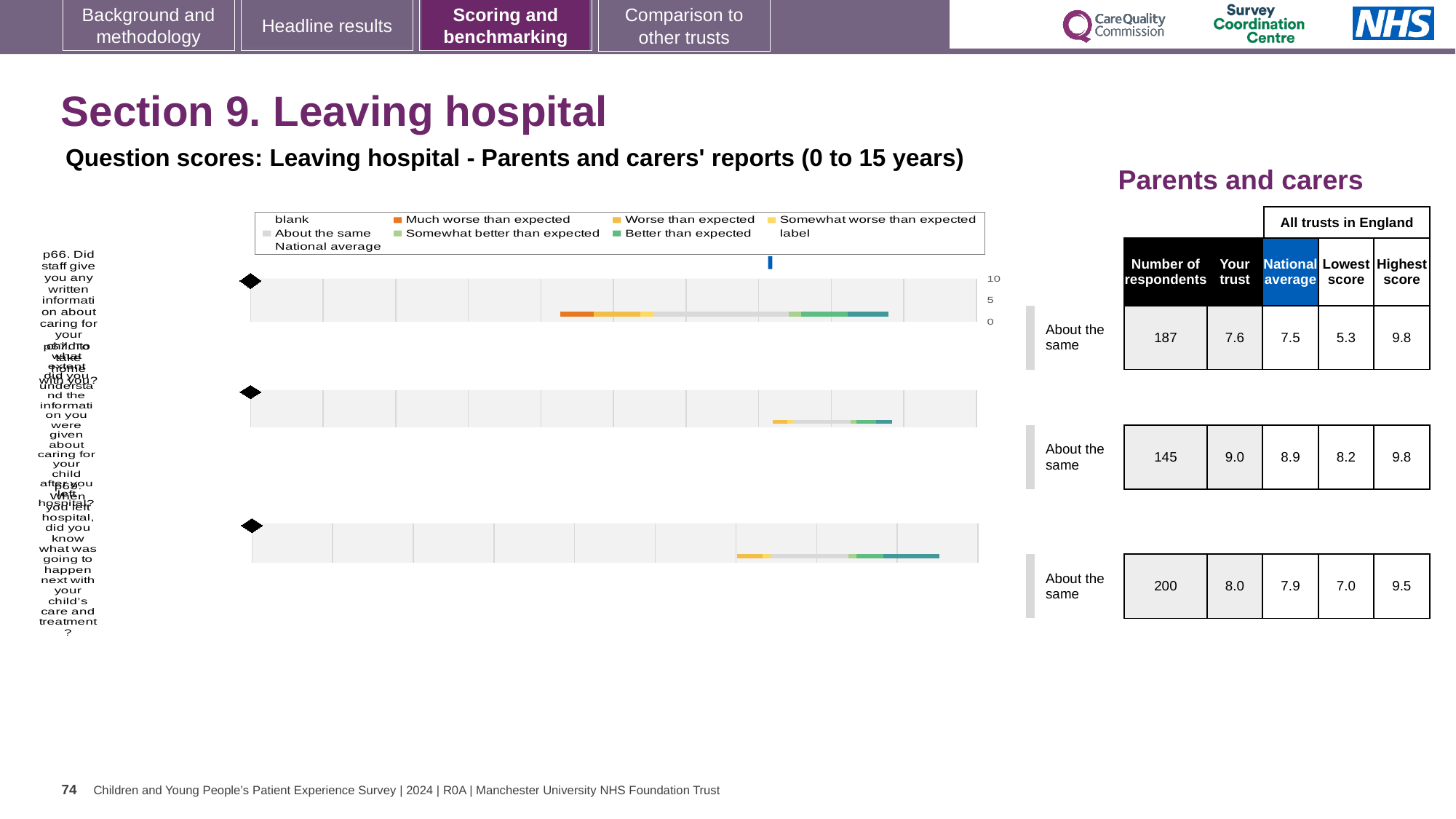
Which benchmarking row (top, middle or bottom) has the lowest 'Lowest score' value in the table? top How many benchmarking bar charts are shown on the slide? 3 In the table beside the middle benchmarking chart, what is the 'National average' score? 8.9 Which benchmarking row (top, middle or bottom) has the highest 'Your trust' score in the table? middle In the table beside the bottom benchmarking chart, what is the 'Number of respondents'? 200 In the legend above the benchmarking charts, which category is shown in orange? Much worse than expected Is the 'Your trust' score for the bottom row larger or smaller than its 'National average' score? larger What kind of chart is used for the three benchmarking rows on the left of the slide? bar chart In the legend above the benchmarking charts, which category is shown in dark teal? Better than expected What is the difference between the 'Your trust' scores of the middle row and the top row in the table? 1.4 How many entries does the legend above the benchmarking charts list? 9 In the table beside the top benchmarking chart, what is the 'Your trust' score? 7.6